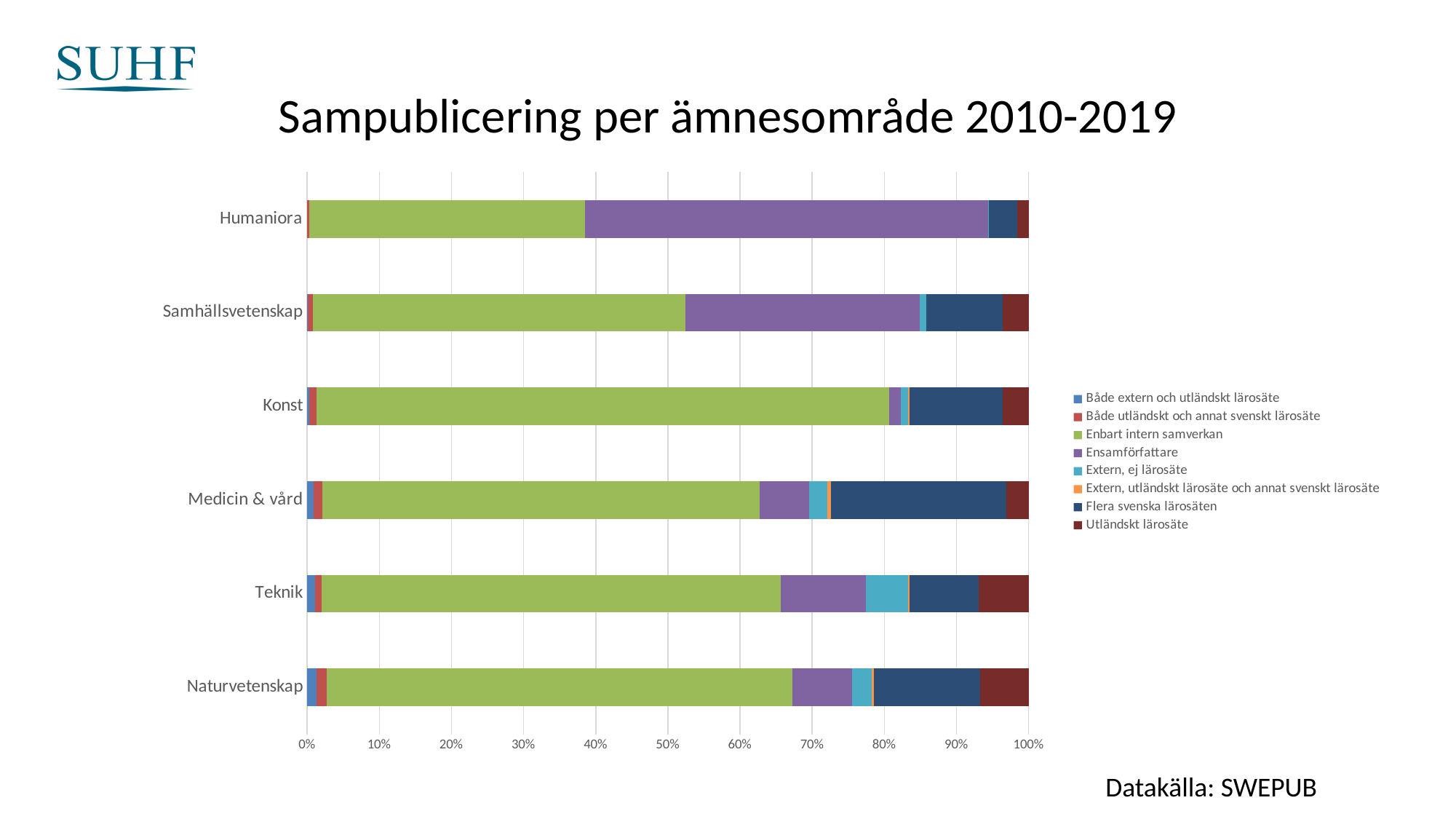
What is the title of the chart? Sampublicering per ämnesområde 2010-2019 What does each stacked bar total on the x axis? 100% How many subject areas (categories) are shown on the chart? 6 Which subject area has the largest Flera svenska lärosäten share? Medicin & vård How many series does the legend list? 8 Which subject area has the largest Enbart intern samverkan share? Konst Is the Enbart intern samverkan share for Naturvetenskap greater or less than 60%? greater Which has the larger Ensamförfattare share, Humaniora or Konst? Humaniora Is the Enbart intern samverkan share for Humaniora greater or less than 40%? less Is the Enbart intern samverkan share for Samhällsvetenskap greater or less than 50%? greater What kind of chart is shown on the slide? Stacked bar chart Which subject area has the largest Ensamförfattare share? Humaniora